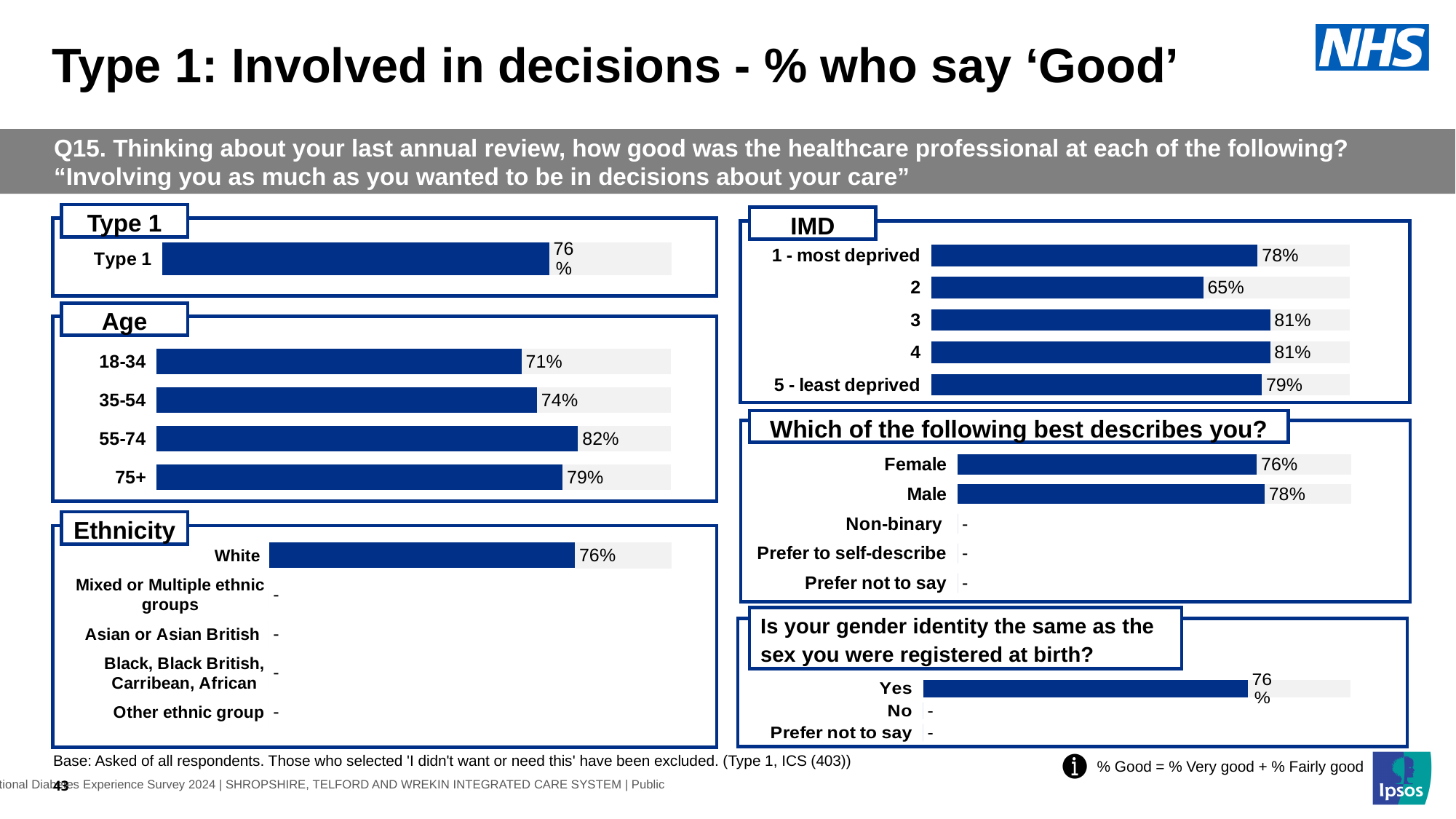
In the Age chart, how many age groups are shown? 4 What type of chart is used in the IMD section? Bar chart In the 'Which of the following best describes you?' chart, which is larger, Female or Male? Male In the Age chart, which age group has the highest percentage? 55-74 In the Ethnicity chart, what is the value for White? 76% In the Age chart, which age group has the lowest percentage? 18-34 In the IMD chart, what is the difference between '5 - least deprived' and '1 - most deprived'? 1 percentage point In the Age chart, what is the difference between the 75+ and 18-34 values? 8 percentage points In the Age chart, what is the value for the 55-74 age group? 82% In the IMD chart, what is the value for '2'? 65% In the Type 1 chart, what percentage of Type 1 respondents say 'Good'? 76% In the IMD chart, which category has the lowest percentage? 2